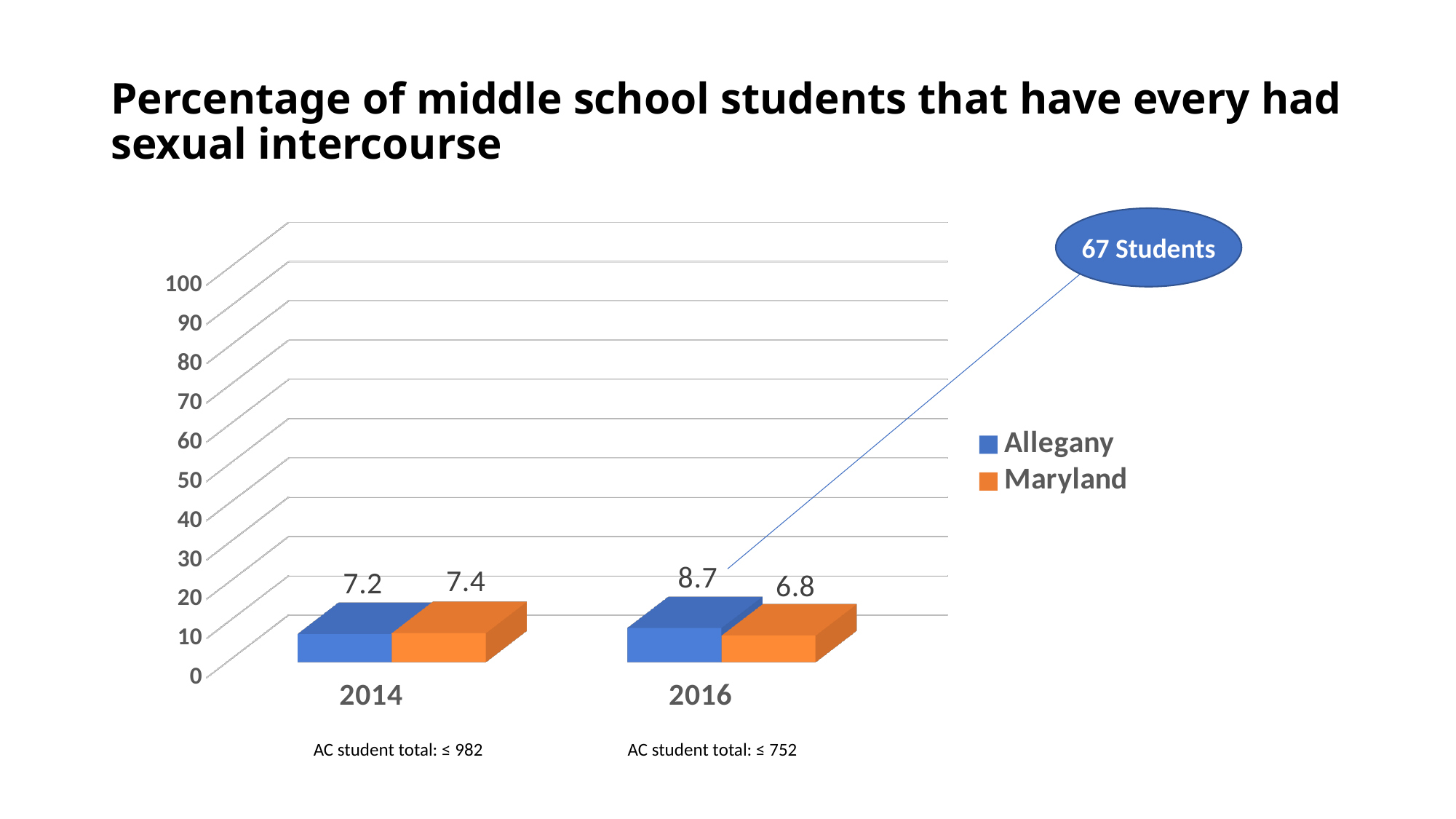
What is the difference between the Allegany values for 2016 and 2014? 1.5 Does the Maryland value rise or fall from 2014 to 2016? fall What is the value for Allegany in 2014? 7.2 In which year is the Allegany value highest? 2016 What is the difference between the Allegany and Maryland values in 2016? 1.9 What is the value for Maryland in 2016? 6.8 What is the value for Maryland in 2014? 7.4 What is the value for Allegany in 2016? 8.7 Which series has the higher value in 2016, Allegany or Maryland? Allegany What kind of chart is shown on the slide? bar chart In which year is the Maryland value lowest? 2016 How many series does the legend list? 2